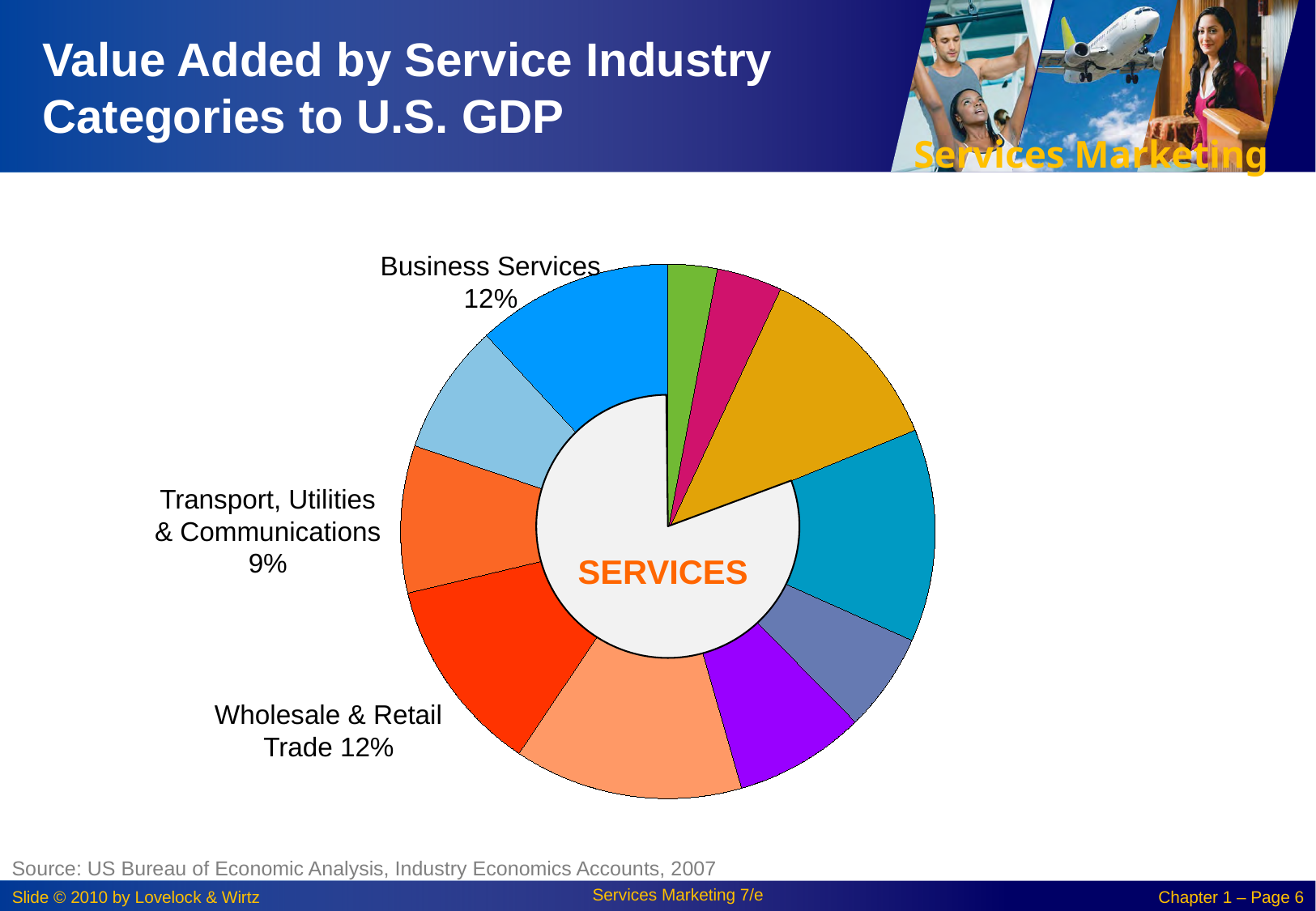
What is the title of the slide containing the chart? Value Added by Service Industry Categories to U.S. GDP What percentage is labeled for Wholesale & Retail Trade? 12% How many slices does the pie chart contain? 11 What word is printed in the center of the pie chart? SERVICES What is the combined share of the three labeled categories (Business Services, Transport, Utilities & Communications, and Wholesale & Retail Trade)? 33% What percentage is shown for Transport, Utilities & Communications? 9% Of the three labeled categories, which has the smallest share? Transport, Utilities & Communications Is the share for Business Services equal to the share for Wholesale & Retail Trade? Yes What type of chart is shown on the slide? Pie chart By how many percentage points does Wholesale & Retail Trade exceed Transport, Utilities & Communications? 3% Which is larger, the share for Business Services or the share for Transport, Utilities & Communications? Business Services What share of U.S. GDP value added is attributed to Business Services in the pie chart? 12%